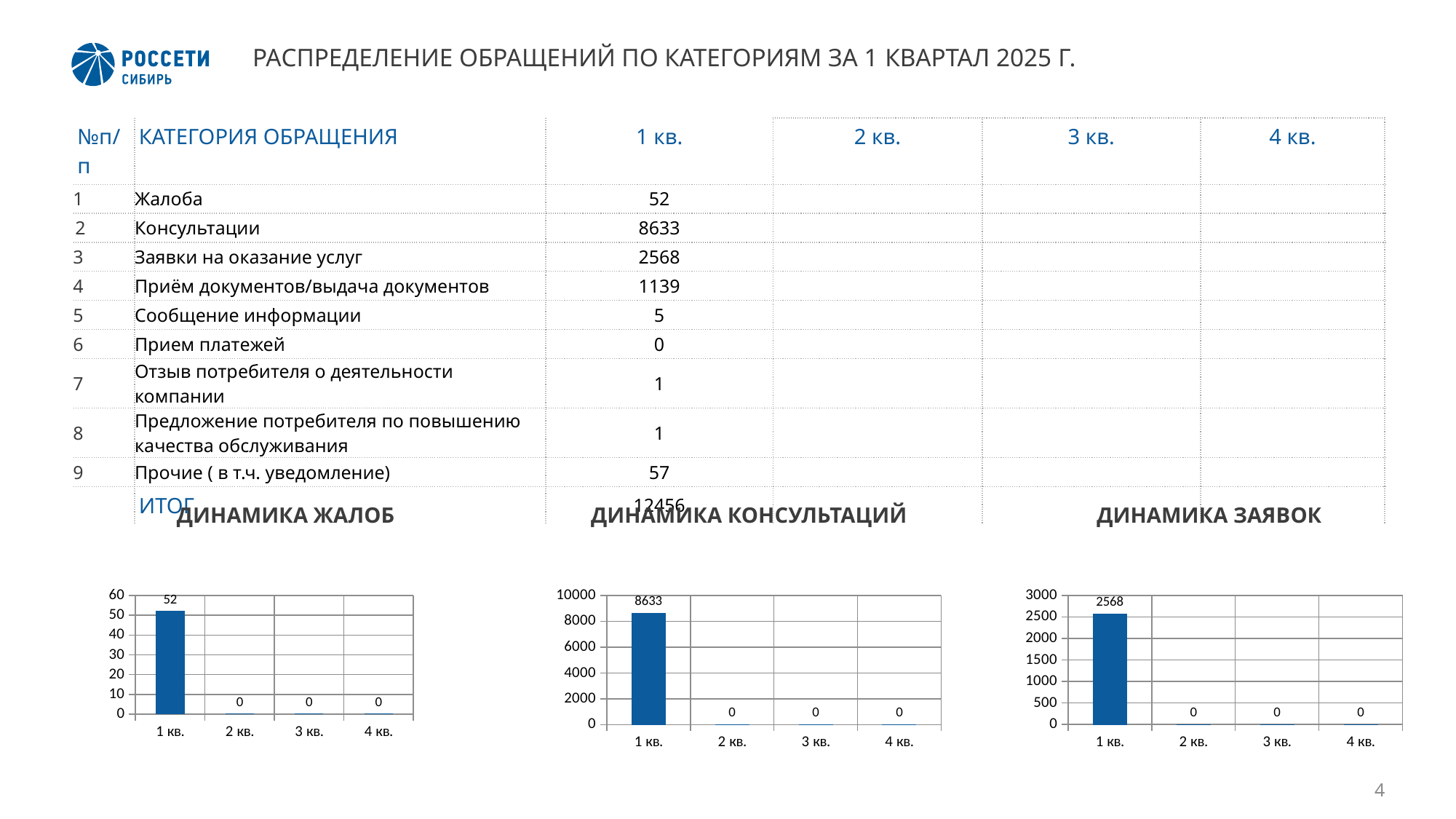
In the chart titled ДИНАМИКА ЖАЛОБ, what is the value for 1 кв.? 52 In the chart titled ДИНАМИКА ЖАЛОБ, which quarter has the highest value? 1 кв. In the chart titled ДИНАМИКА ЗАЯВОК, what is the value for 1 кв.? 2568 In the chart titled ДИНАМИКА ЗАЯВОК, is the value for 1 кв. greater or less than 2500? greater In the chart titled ДИНАМИКА КОНСУЛЬТАЦИЙ, what is the value for 1 кв.? 8633 In the chart titled ДИНАМИКА КОНСУЛЬТАЦИЙ, is the value for 1 кв. greater or less than 8000? greater In the chart titled ДИНАМИКА ЗАЯВОК, what is the value for 3 кв.? 0 In the chart titled ДИНАМИКА КОНСУЛЬТАЦИЙ, how many categories are shown on the x axis? 4 In the chart titled ДИНАМИКА ЖАЛОБ, do the values rise or fall from 1 кв. to 4 кв.? fall What is the title of the middle chart on the slide? ДИНАМИКА КОНСУЛЬТАЦИЙ In the chart titled ДИНАМИКА ЖАЛОБ, what is the difference between the values for 1 кв. and 2 кв.? 52 What kind of chart is the chart titled ДИНАМИКА ЗАЯВОК? bar chart